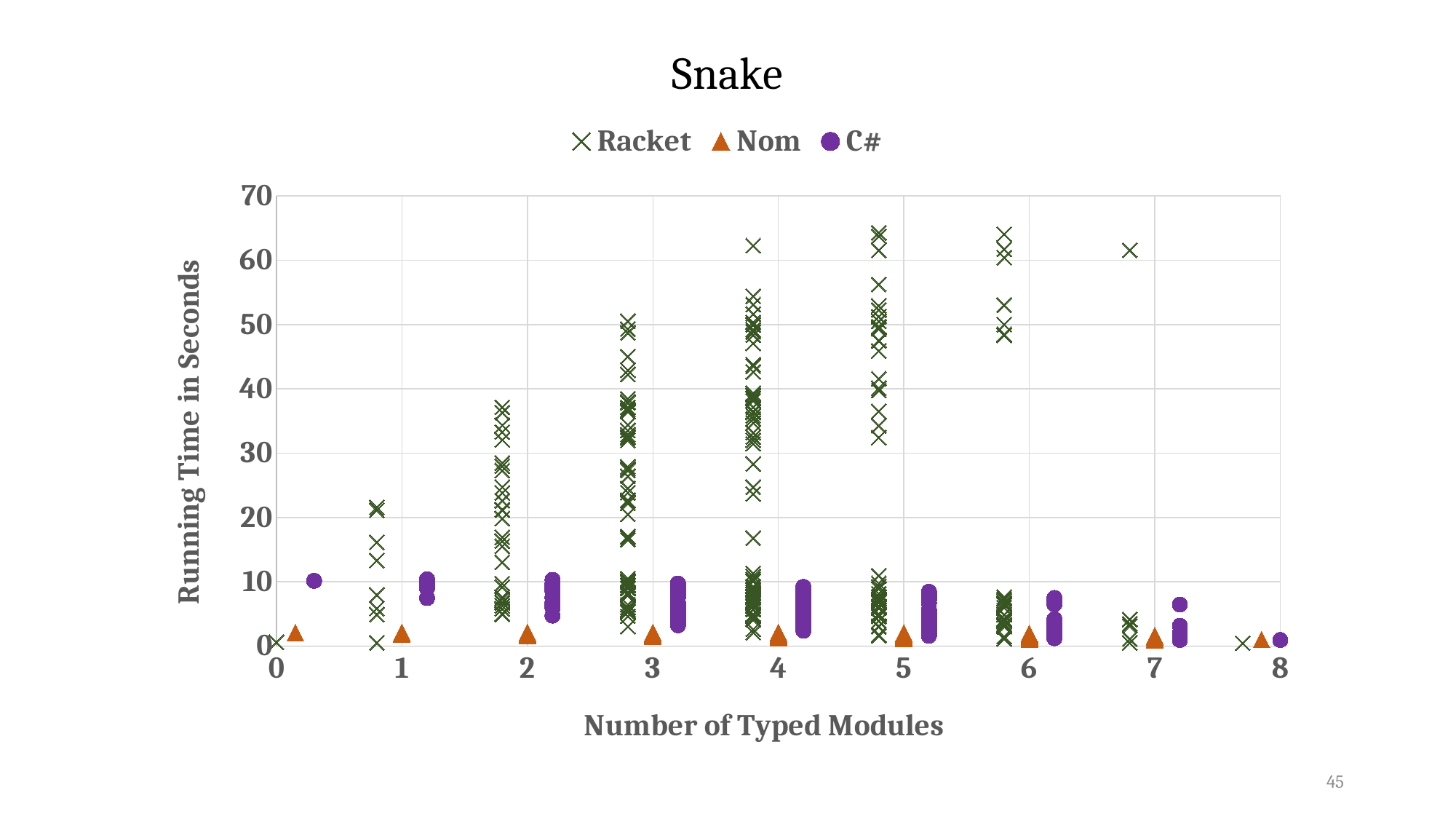
What is the title of the chart? Snake What is the highest value shown on the y axis? 70 How many series does the legend list? 3 At 7 typed modules, which series has the higher maximum running time, Racket or C#? Racket Is the highest Racket running time at 8 typed modules greater or less than 10 seconds? less Is the highest Racket running time at 4 typed modules greater or less than 60 seconds? greater What kind of chart is shown on the slide? scatter chart Which series reaches the highest running time on the chart? Racket What is the label of the y axis? Running Time in Seconds Are the Nom running times at 3 typed modules greater or less than 10 seconds? less